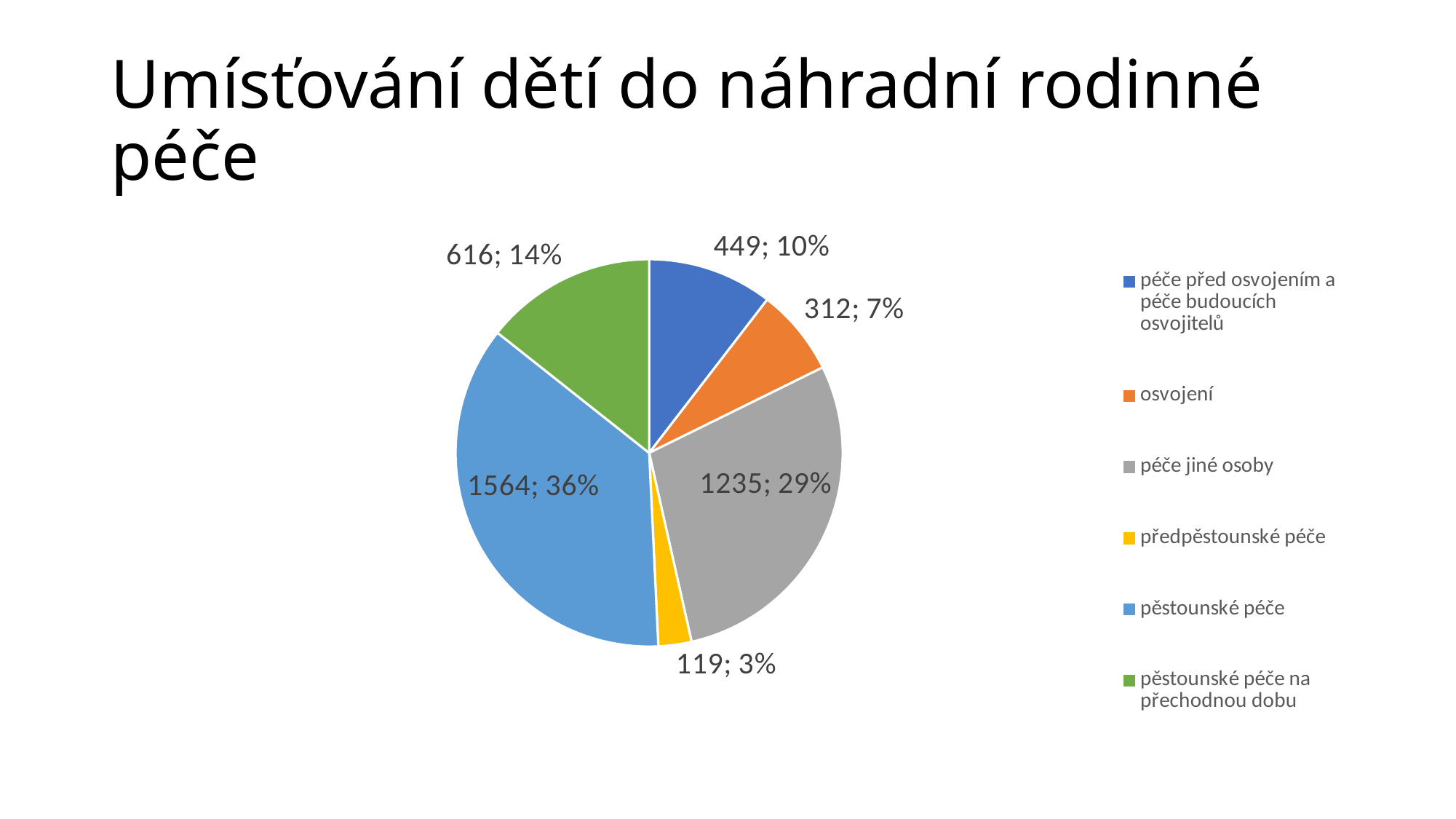
What is the title of the slide containing the chart? Umísťování dětí do náhradní rodinné péče Which category has the largest slice? pěstounské péče What percentage share does pěstounské péče na přechodnou dobu have? 14% How many slices does the pie chart have? 6 Which is larger, the value for osvojení or the value for péče před osvojením a péče budoucích osvojitelů? péče před osvojením a péče budoucích osvojitelů What percentage share does předpěstounské péče have? 3% What is the difference between the values for pěstounské péče and péče jiné osoby? 329 What is the value shown for osvojení? 312 What is the value shown for péče jiné osoby? 1235 What kind of chart is shown on the slide? pie chart Which category has the smallest slice? předpěstounské péče What is the value shown for pěstounské péče? 1564